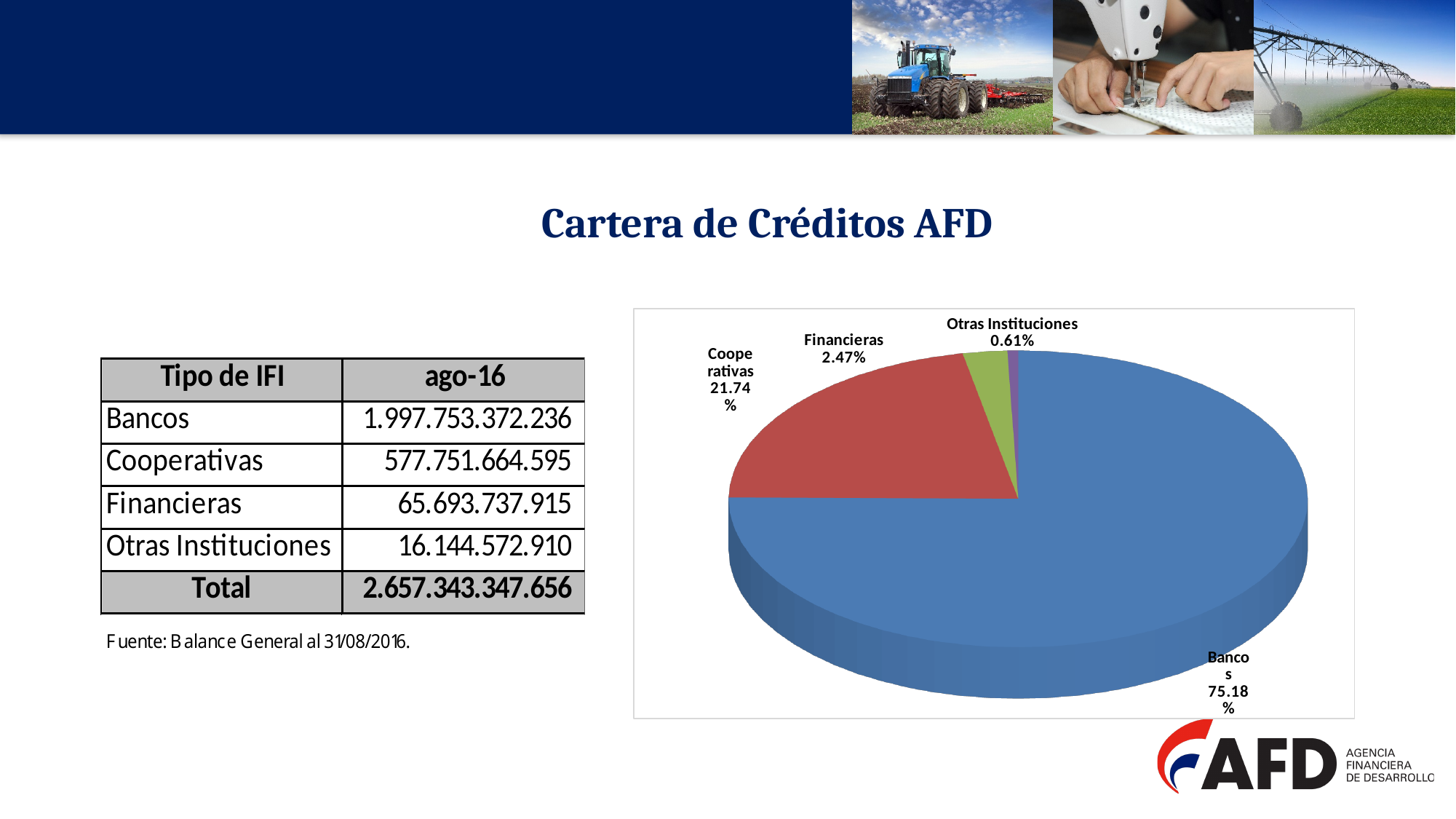
How many slices does the pie chart have? 4 What is the title of the slide containing the pie chart? Cartera de Créditos AFD Which slice is larger, Cooperativas or Financieras? Cooperativas What share of the pie does Financieras represent? 2.47% What colour is the Bancos slice of the pie? Blue What share of the pie does Otras Instituciones represent? 0.61% What share of the pie does Cooperativas represent? 21.74% Which category has the smallest slice of the pie? Otras Instituciones What is the difference in percentage points between the Bancos slice and the Cooperativas slice? 53.44 What kind of chart is shown on the slide? Pie chart Which category has the largest slice of the pie? Bancos